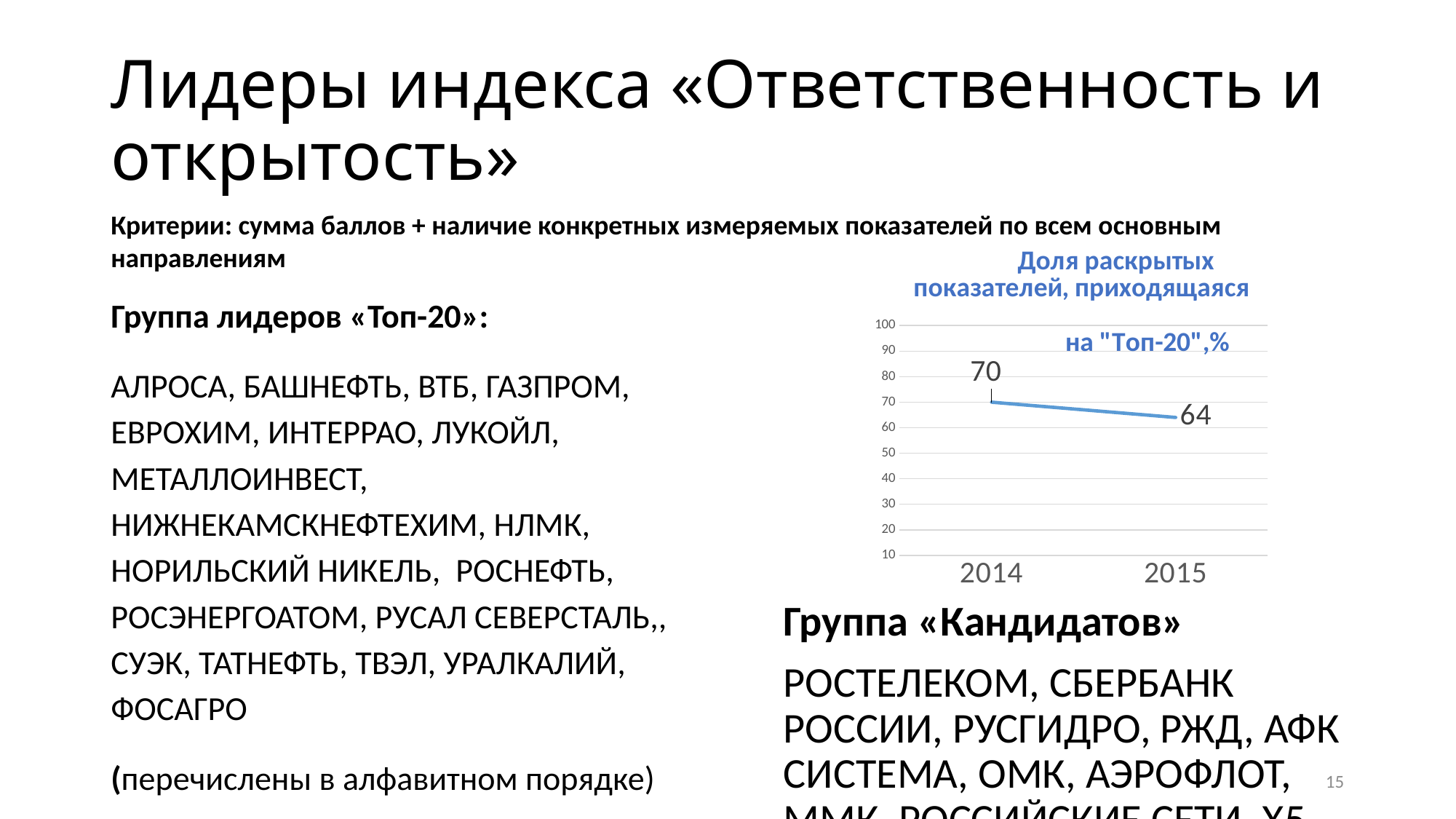
Is the value for 2014 larger or smaller than the value for 2015? larger How many data points are plotted in the chart? 2 Which year has the higher value in the chart? 2014 Do the values rise or fall from 2014 to 2015? fall What is the maximum value shown on the chart's vertical axis? 100 What kind of chart is shown on the slide? line chart What is the value for 2014 in the chart? 70 What is the title of the chart? Доля раскрытых показателей, приходящаяся на "Топ-20",% Which year has the lower value in the chart? 2015 What is the value for 2015 in the chart? 64 What is the difference between the 2014 and 2015 values in the chart? 6 Is the value for 2015 greater or less than 80? less